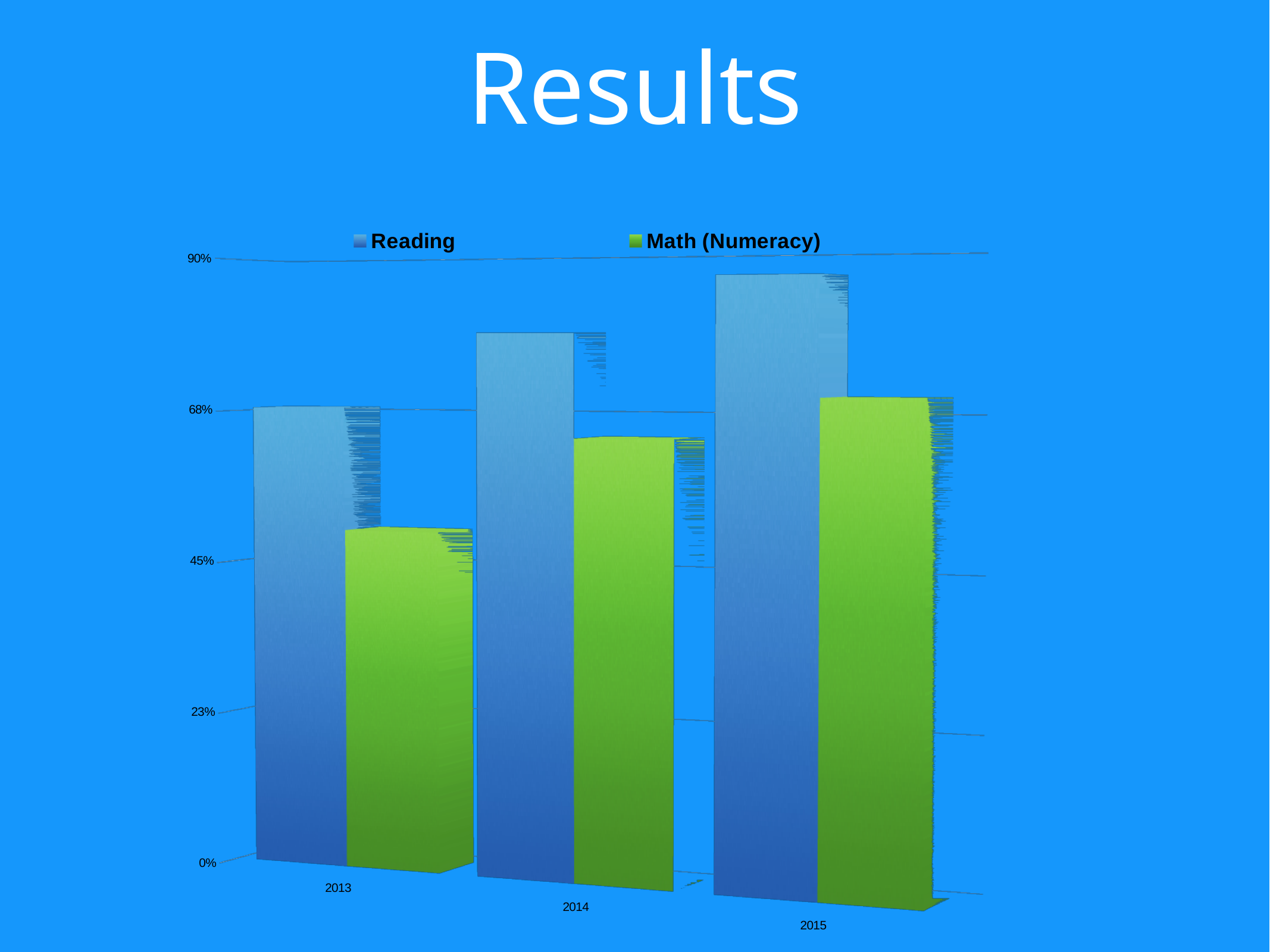
What kind of chart is shown on the slide? bar chart Which year has the highest Reading value? 2015 What is the title of the slide containing the chart? Results Which year has the lowest Reading value? 2013 Which year has the lowest Math (Numeracy) value? 2013 How many series does the legend list? 2 Is the Math (Numeracy) value for 2014 greater or less than 45%? greater Is the Reading value for 2014 greater or less than 68%? greater Do the Reading values rise or fall from 2013 to 2015? rise In 2013, which is larger, Reading or Math (Numeracy)? Reading How many years are shown on the x axis? 3 Is the Math (Numeracy) value for 2013 greater or less than 68%? less